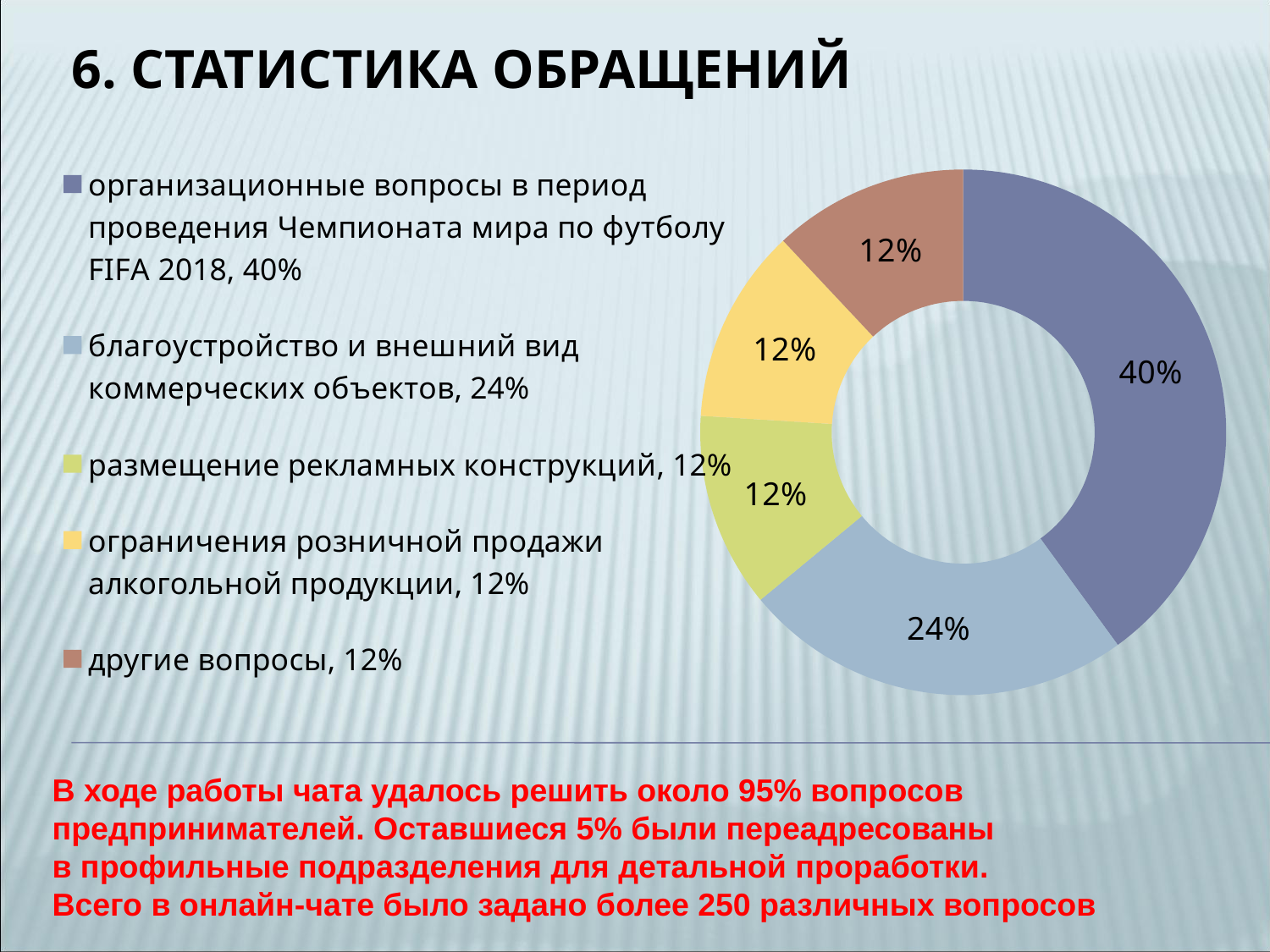
What kind of chart is shown on the slide? Doughnut (pie) chart What share of requests concerned organizational questions during the FIFA 2018 World Cup (организационные вопросы в период проведения Чемпионата мира по футболу FIFA 2018)? 40% How many categories does the chart show? 5 What share of requests concerned improvement and appearance of commercial objects (благоустройство и внешний вид коммерческих объектов)? 24% How many categories share the same value of 12%? 3 What share of requests concerned restrictions on retail sale of alcohol (ограничения розничной продажи алкогольной продукции)? 12% By how many percentage points does the share for organizational questions during the FIFA 2018 World Cup exceed the share for improvement and appearance of commercial objects? 16 percentage points What share of requests concerned placement of advertising structures (размещение рекламных конструкций)? 12% Which is larger: the share for improvement and appearance of commercial objects or the share for other questions? благоустройство и внешний вид коммерческих объектов What colour is the slice for other questions (другие вопросы)? Brown What share of requests fell under other questions (другие вопросы)? 12% Which category has the largest share of requests? организационные вопросы в период проведения Чемпионата мира по футболу FIFA 2018